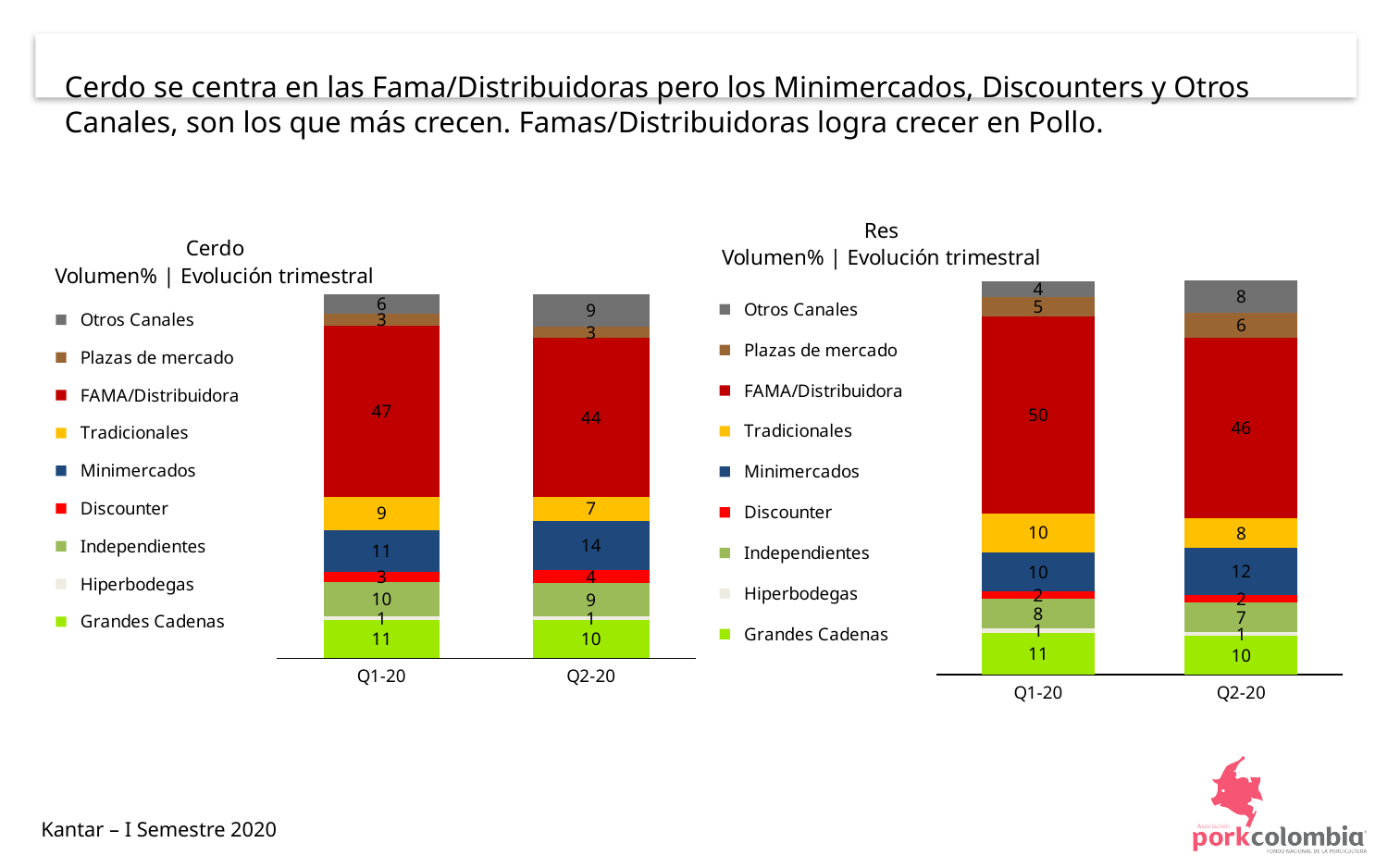
In the Cerdo chart, what is the value for Minimercados in Q2-20? 14 In the Res chart, which channel has the smallest segment in Q1-20? Hiperbodegas In the Res chart, what is the value for FAMA/Distribuidora in Q2-20? 46 What type of chart is the Res chart? Stacked bar chart How many series does the legend of the Res chart list? 9 In the Cerdo chart, which channel has the largest segment in Q2-20? FAMA/Distribuidora In the Res chart, what is the value for Otros Canales in Q1-20? 4 In the Cerdo chart, is the Tradicionales value larger in Q1-20 or Q2-20? Q1-20 In the Res chart, what is the difference between the Minimercados values in Q2-20 and Q1-20? 2 In the Cerdo chart, what is the value for FAMA/Distribuidora in Q1-20? 47 How many quarters are shown on the x axis of the Cerdo chart? 2 In the Cerdo chart, by how much did the FAMA/Distribuidora value change from Q1-20 to Q2-20? 3